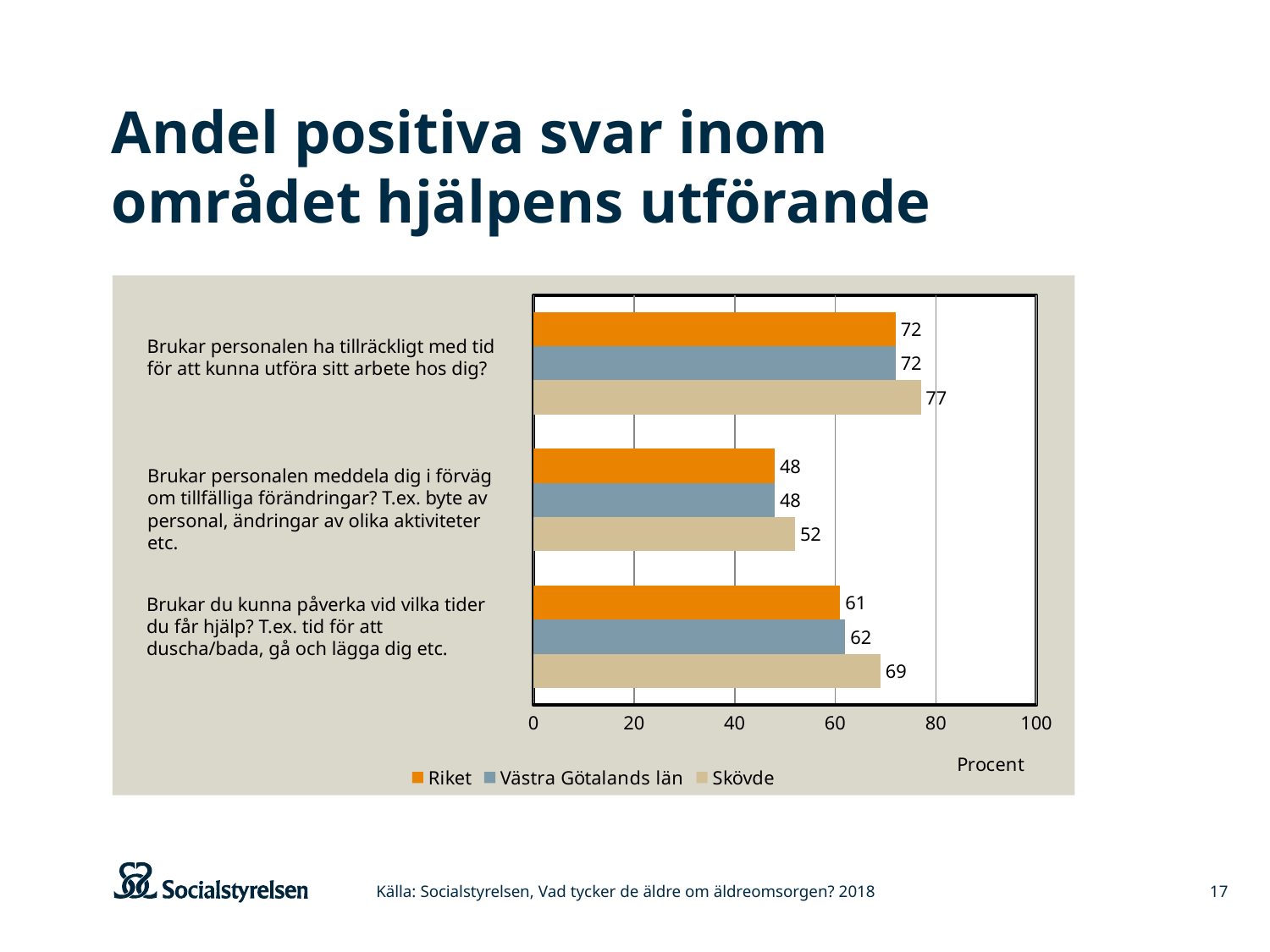
What is the value for Västra Götalands län on the question about staff notifying you in advance of temporary changes ("Brukar personalen meddela dig i förväg...")? 48 How many series does the legend list? 3 What is the value for Skövde on the question about whether staff usually have enough time to do their work ("Brukar personalen ha tillräckligt med tid...")? 77 Which question category has the highest value for Skövde? Brukar personalen ha tillräckligt med tid för att kunna utföra sitt arbete hos dig? Is the Skövde value on the question about staff notifying you in advance of temporary changes greater or less than 60? less On the question about staff having enough time, which is larger: the value for Skövde or the value for Riket? Skövde How many question categories are shown on the chart? 3 What kind of chart is shown on the slide? Bar chart Which question category has the lowest value for Riket? Brukar personalen meddela dig i förväg om tillfälliga förändringar? What is the value for Riket on the question about being able to influence at what times you get help ("Brukar du kunna påverka vid vilka tider du får hjälp?")? 61 What unit is shown on the horizontal axis of the chart? Procent What is the difference between the Skövde value and the Riket value on the question about being able to influence at what times you get help? 8